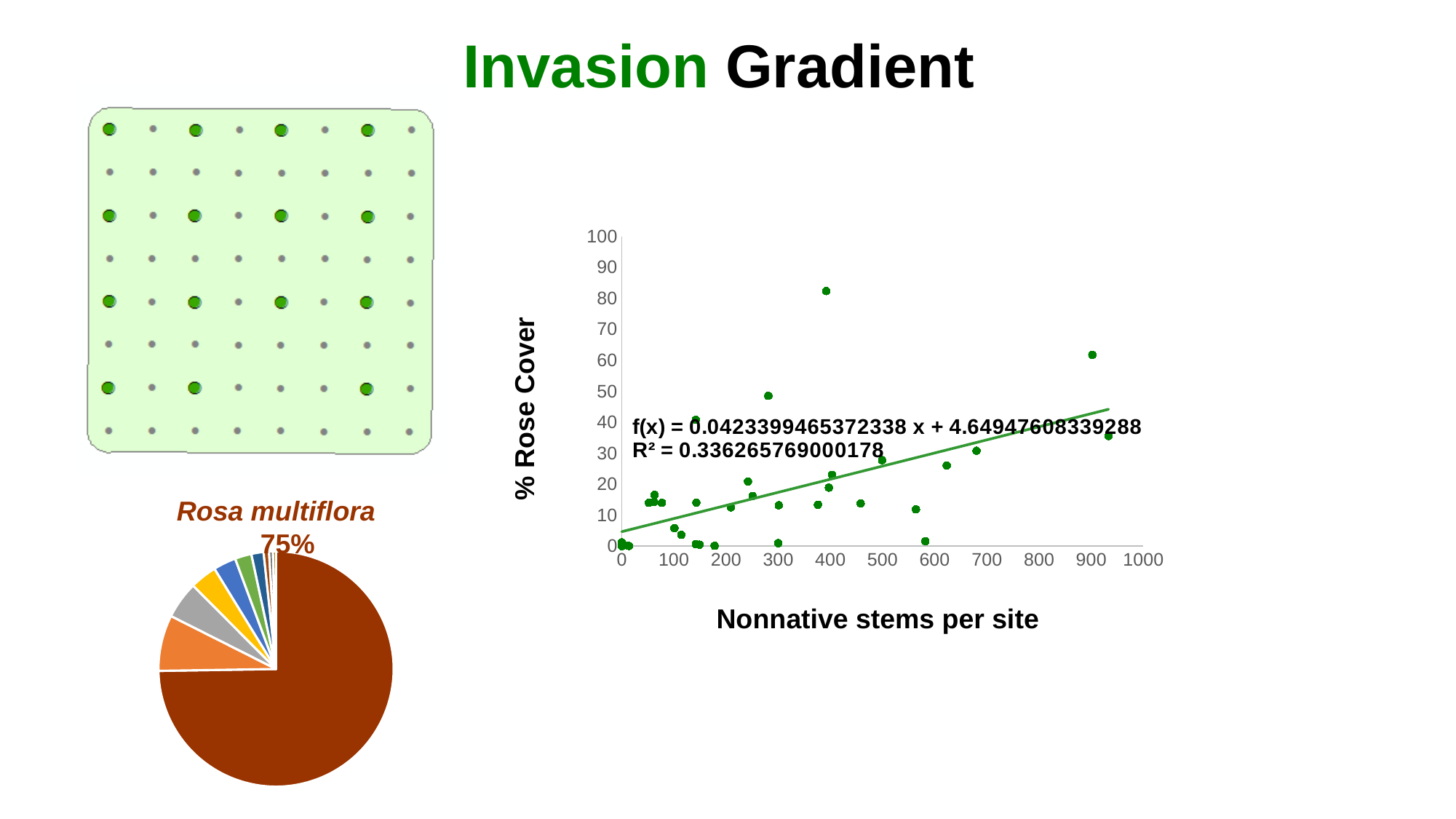
In the scatter chart on the right, do the values of % Rose Cover generally rise or fall as Nonnative stems per site increases along the x axis? rise In the pie chart at the bottom left, what share of the pie does the Rosa multiflora slice take? 75% In the scatter chart on the right, is the % Rose Cover value for the point near 280 nonnative stems per site greater or less than 40? greater In the pie chart at the bottom left, which labelled slice is the largest? Rosa multiflora What is the x-axis title of the scatter chart on the right? Nonnative stems per site What kind of chart is the chart at the bottom left of the slide? pie chart What kind of chart is the chart on the right of the slide? scatter chart In the scatter chart on the right, is the highest plotted % Rose Cover value greater or less than 70? greater In the scatter chart on the right, what is the trendline equation printed on the chart? f(x) = 0.0423399465372338 x + 4.64947608339288 What is the y-axis title of the scatter chart on the right? % Rose Cover In the scatter chart on the right, is the % Rose Cover value for the point near 900 nonnative stems per site greater or less than 50? greater In the scatter chart on the right, what is the R² value printed on the chart? R² = 0.336265769000178